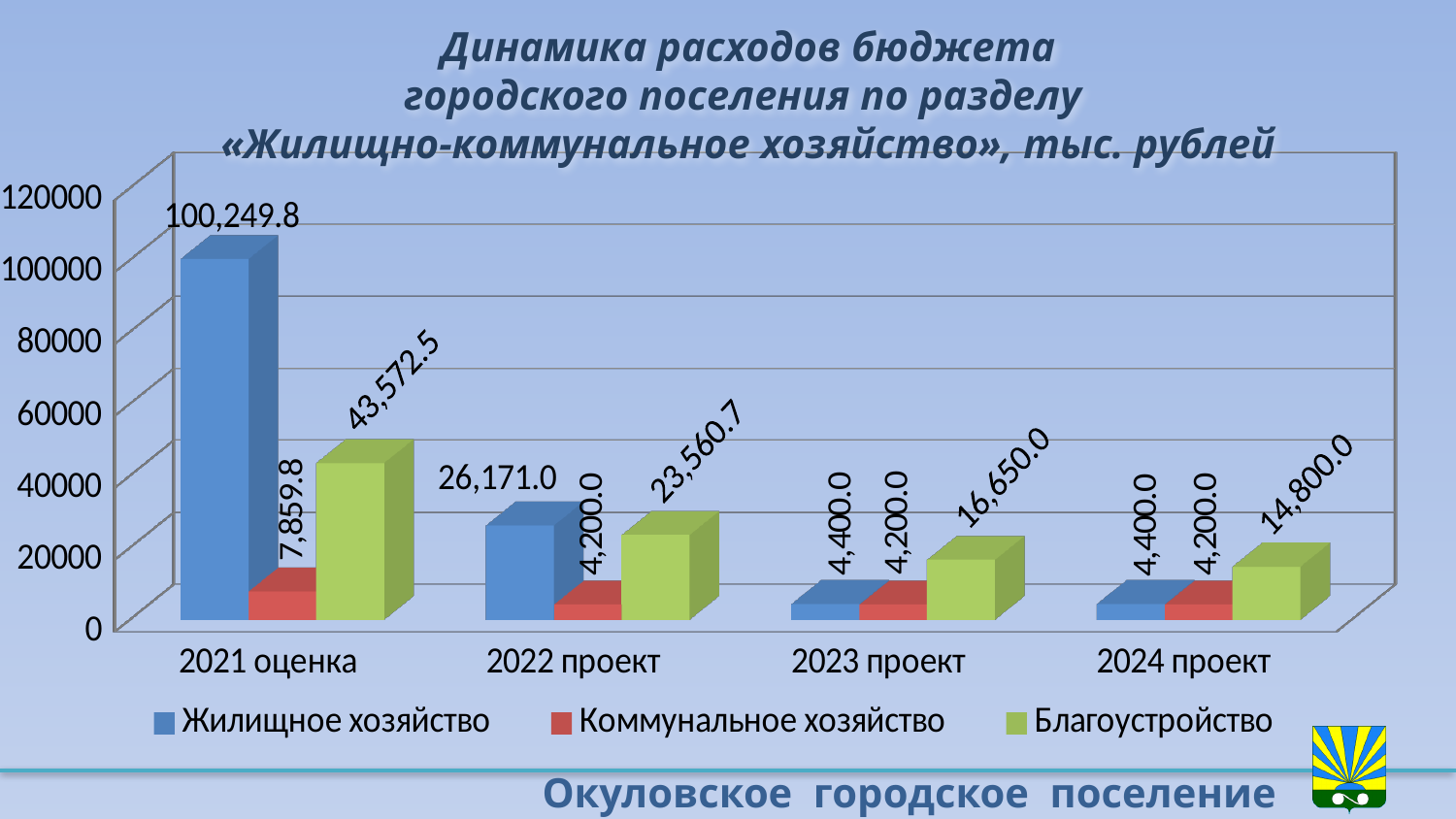
What is the difference between Жилищное хозяйство and Благоустройство in 2021 оценка? 56,677.3 What is the value for Жилищное хозяйство in 2021 оценка? 100,249.8 Which is larger in 2022 проект: Жилищное хозяйство or Благоустройство? Жилищное хозяйство Which category has the highest value for Жилищное хозяйство? 2021 оценка What is the value for Коммунальное хозяйство in 2021 оценка? 7,859.8 What is the difference between Благоустройство in 2023 проект and 2024 проект? 1,850.0 What is the value for Благоустройство in 2024 проект? 14,800.0 Which category has the lowest value for Благоустройство? 2024 проект How many series does the legend list? 3 What is the value for Благоустройство in 2022 проект? 23,560.7 How many categories are shown on the x axis? 4 Does the value for Благоустройство rise or fall from 2021 оценка to 2024 проект? fall